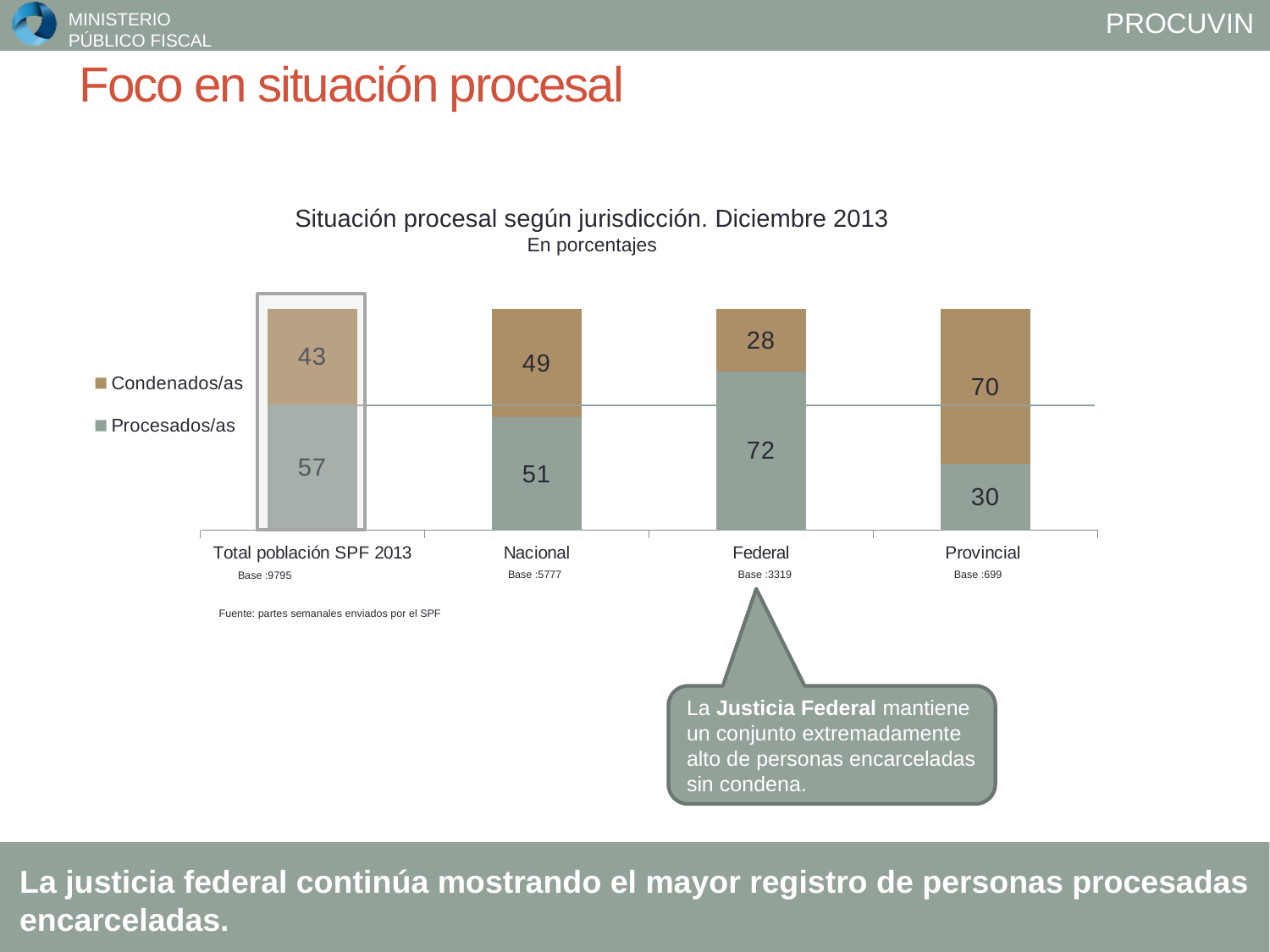
What is the value for Condenados/as in the Provincial category? 70 What kind of chart is shown? Stacked bar chart What is the value for Procesados/as in the Federal category? 72 How many categories are shown on the x axis? 4 How many series does the legend list? 2 What is the title of the chart? Situación procesal según jurisdicción. Diciembre 2013 Which is larger in the Nacional category, Procesados/as or Condenados/as? Procesados/as What is the difference between Procesados/as and Condenados/as in the Provincial category? 40 Which category has the highest value for Procesados/as? Federal What is the value for Procesados/as in the Total población SPF 2013 category? 57 What is the value for Condenados/as in the Nacional category? 49 Which category has the lowest value for Condenados/as? Federal